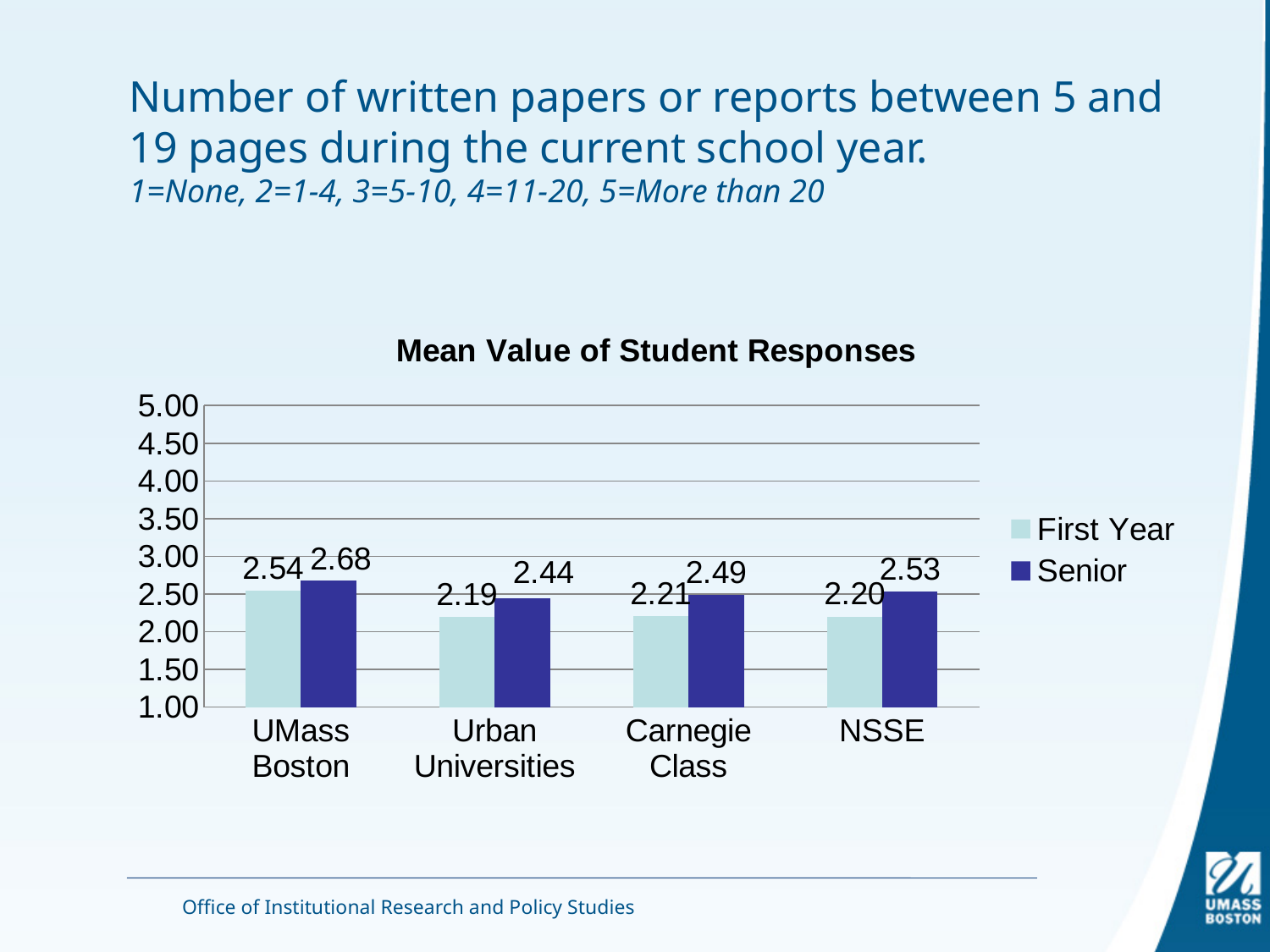
What is the title of the chart? Mean Value of Student Responses What kind of chart is shown on the slide? bar chart Which category has the lowest First Year mean value? Urban Universities What is the Senior mean value for NSSE? 2.53 What is the First Year mean value for UMass Boston? 2.54 Which is larger for UMass Boston, the First Year or the Senior mean value? Senior How many series does the legend list? 2 Which category has the highest Senior mean value? UMass Boston What is the Senior mean value for Carnegie Class? 2.49 What is the difference between the Senior and First Year mean values for Urban Universities? 0.25 How many categories are shown on the x axis? 4 Is the Senior value for UMass Boston greater or less than 2.50? greater